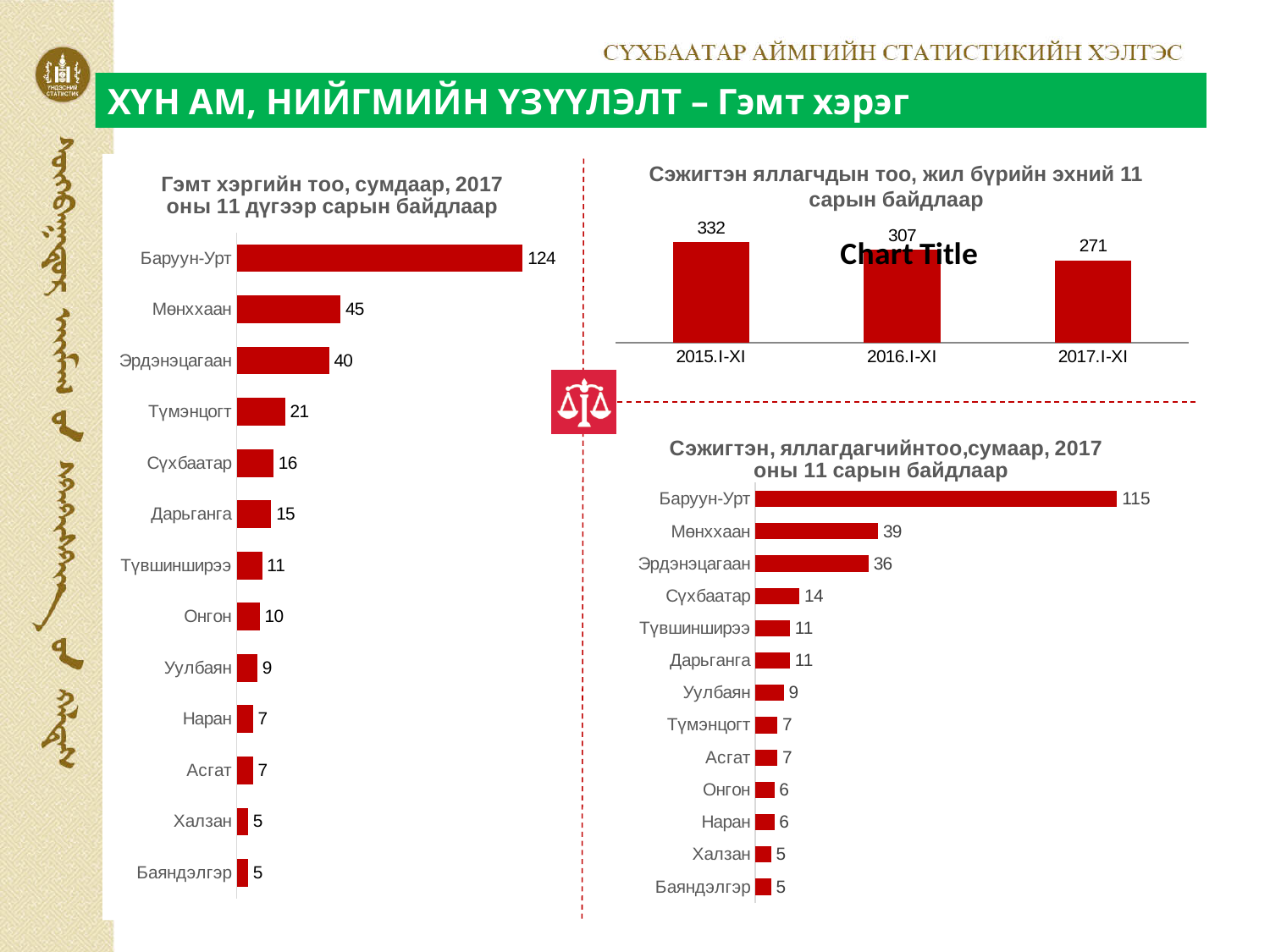
In the top-right chart 'Сэжигтэн яллагчдын тоо', do the values rise or fall from 2015.I-XI to 2017.I-XI? fall In the left chart 'Гэмт хэргийн тоо, сумдаар', which category has the highest value? Баруун-Урт In the top-right chart 'Сэжигтэн яллагчдын тоо, жил бүрийн эхний 11 сарын байдлаар', what is the value for 2016.I-XI? 307 What kind of chart is the top-right chart 'Сэжигтэн яллагчдын тоо'? bar chart In the left chart 'Гэмт хэргийн тоо, сумдаар', which is larger, Түмэнцогт or Сүхбаатар? Түмэнцогт In the left chart 'Гэмт хэргийн тоо, сумдаар, 2017 оны 11 дүгээр сарын байдлаар', what is the value for Баруун-Урт? 124 In the left chart 'Гэмт хэргийн тоо, сумдаар', how many categories are shown? 13 In the top-right chart 'Сэжигтэн яллагчдын тоо', what is the difference between 2015.I-XI and 2017.I-XI? 61 In the bottom-right chart 'Сэжигтэн, яллагдагчийн тоо, сумаар', what is the difference between Баруун-Урт and Эрдэнэцагаан? 79 In the bottom-right chart 'Сэжигтэн, яллагдагчийн тоо, сумаар, 2017 оны 11 сарын байдлаар', what is the value for Мөнххаан? 39 In the bottom-right chart 'Сэжигтэн, яллагдагчийн тоо, сумаар', which category has the lowest value? Халзан and Баяндэлгэр In the left chart 'Гэмт хэргийн тоо, сумдаар', what is the difference between Мөнххаан and Эрдэнэцагаан? 5